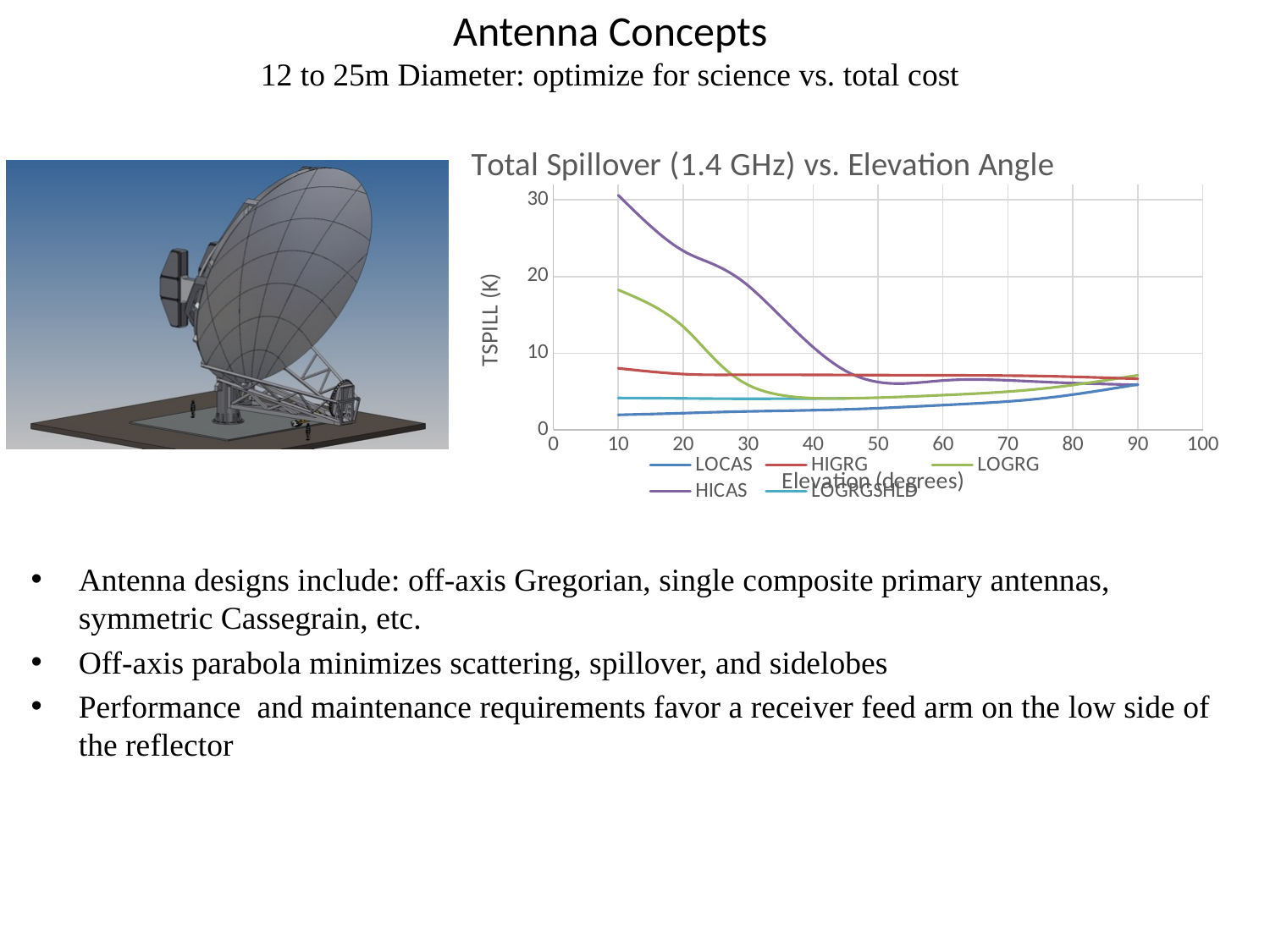
What is the title of the chart? Total Spillover (1.4 GHz) vs. Elevation Angle What is the label of the vertical axis of the chart? TSPILL (K) At 10 degrees elevation, which is larger, the value for HICAS or the value for HIGRG? HICAS How many series does the legend of the chart list? 5 Is the value for LOGRG at 10 degrees elevation greater or less than 10? greater Does the HICAS series rise or fall as elevation increases from 10 to 90 degrees? fall What kind of chart is shown on the slide? line chart Which series has the lowest value at an elevation of 10 degrees? LOCAS Which series has the highest value at an elevation of 10 degrees? HICAS Is the value for LOCAS at 10 degrees elevation greater or less than 10? less Is the value for HICAS at 10 degrees elevation greater or less than 20? greater Does the LOCAS series rise or fall as elevation increases from 10 to 90 degrees? rise